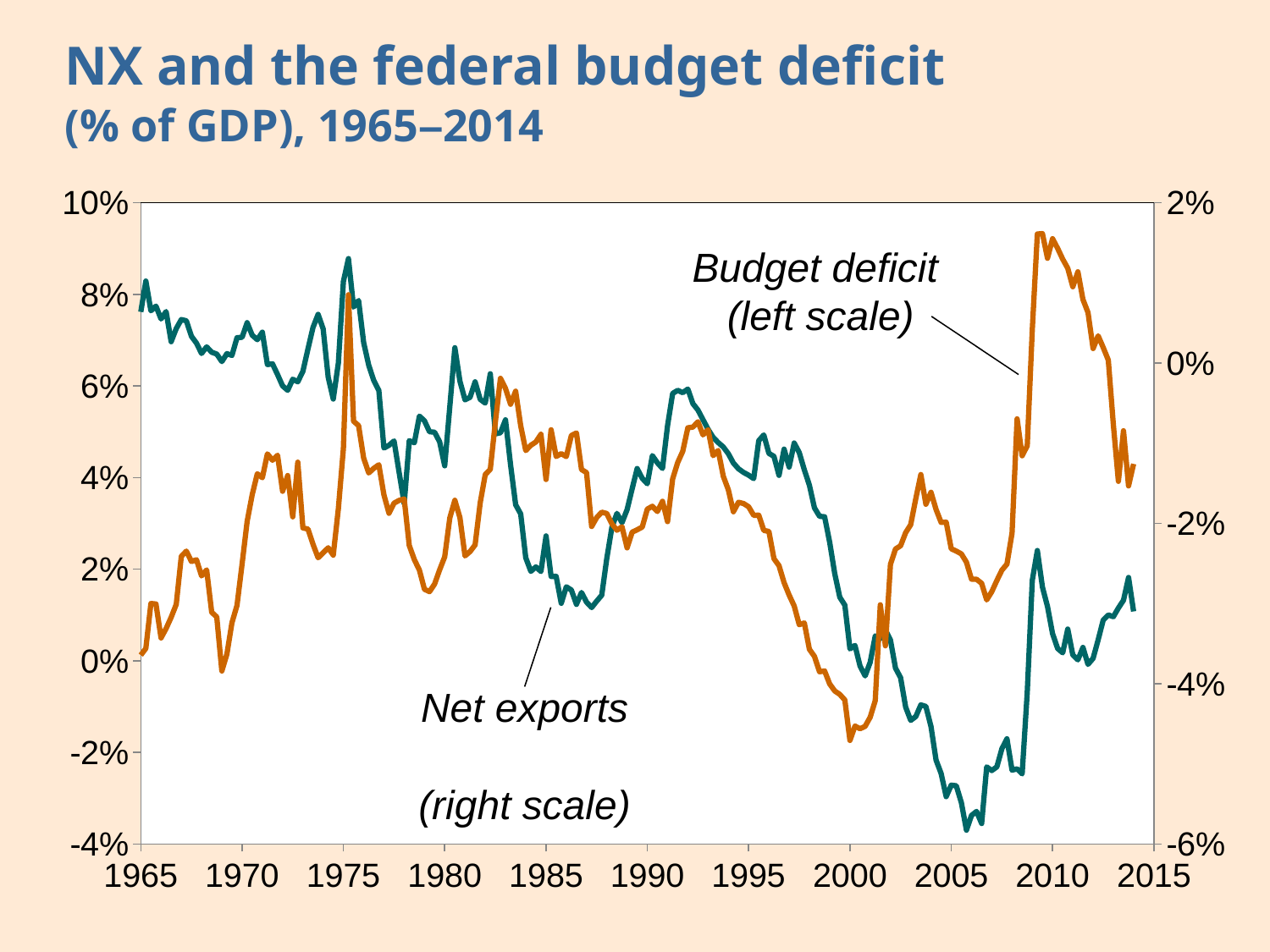
Is the budget deficit value in 1965 greater or less than 2%? less How many data series are plotted on the chart? 2 What kind of chart is shown on the slide? Line chart What is the title of the chart? NX and the federal budget deficit (% of GDP), 1965–2014 Is the budget deficit value around 2000 greater or less than 0%? less Does net exports generally rise or fall from 1965 to 2006? fall Is the net exports value in 1965 greater or less than 0% on the right scale? greater Which is higher: the budget deficit peak around 1975 or the peak around 2009? 2009 Which series is plotted against the right scale? Net exports